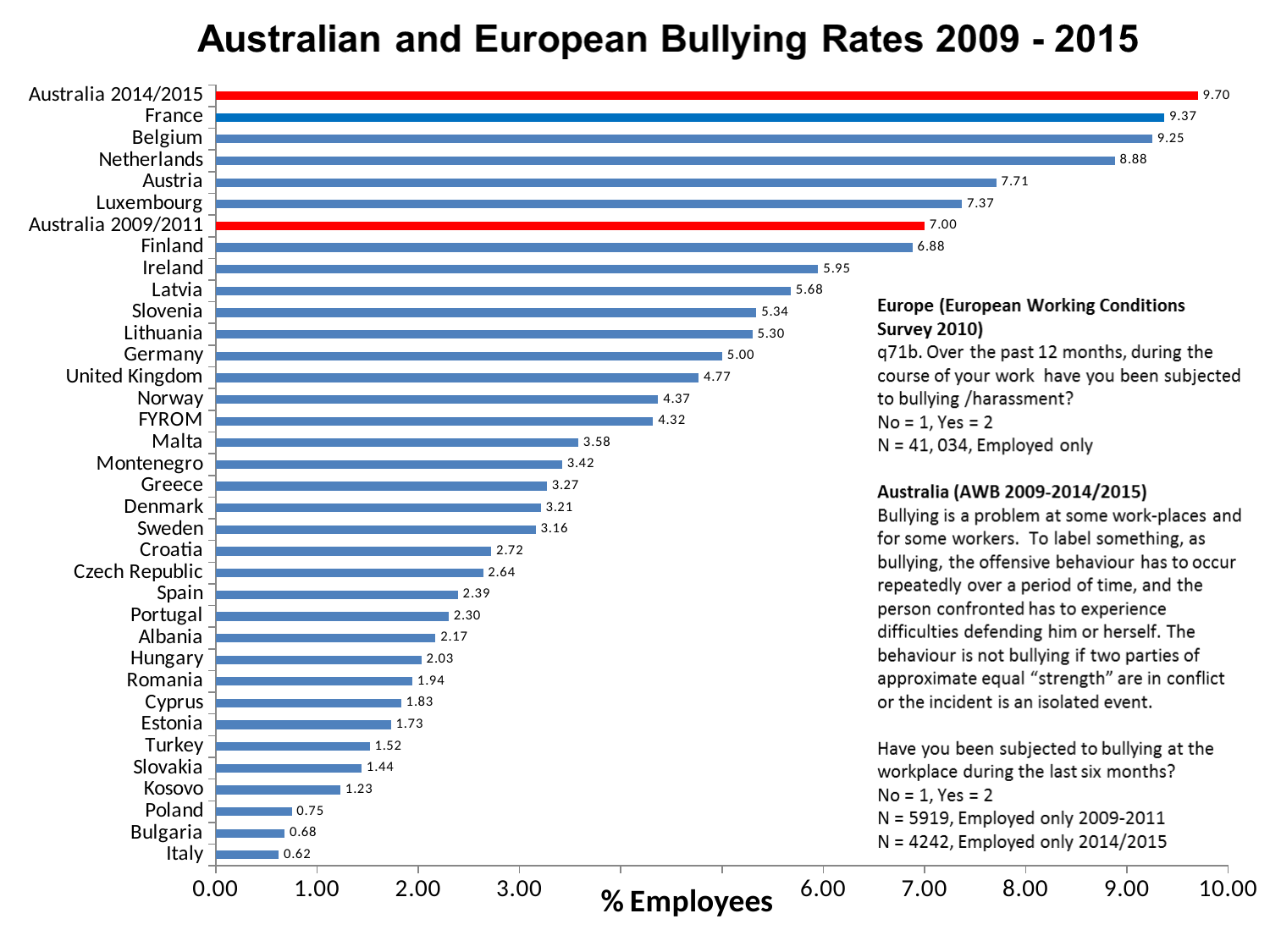
What is the difference between the values for Australia 2014/2015 and Australia 2009/2011? 2.70 What is the title of the chart? Australian and European Bullying Rates 2009 - 2015 How many categories are shown in the chart? 36 Which is larger, the value for Netherlands or the value for Austria? Netherlands What is the value for Italy? 0.62 What is the value for France? 9.37 What is the value for Germany? 5.00 What is the value for Australia 2009/2011? 7.00 Is the value for Ireland greater or less than 5.00? greater Which category has the highest value? Australia 2014/2015 Which category has the lowest value? Italy What kind of chart is shown on the slide? bar chart